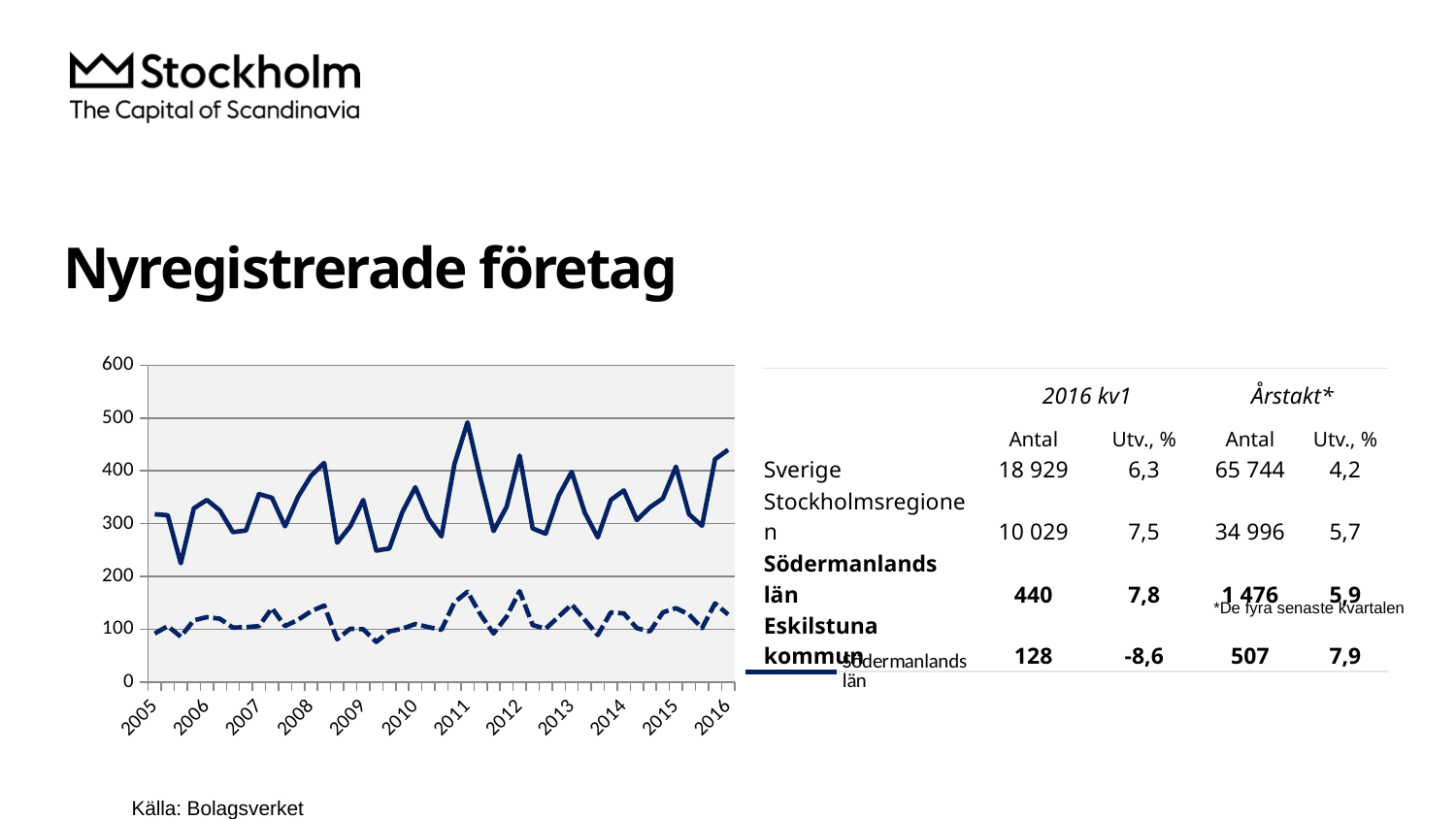
What is the title of the slide above the chart? Nyregistrerade företag How many year labels are shown on the x axis of the chart? 12 Which line is higher throughout the chart, the solid line or the dashed line? the solid line Around which year does the solid line (Södermanlands län) reach its highest value? 2011 Is the value of the solid line at the end of the series (2016) greater or less than 400? greater Is the lowest value of the solid line (Södermanlands län) greater or less than 300? less How many lines are plotted in the chart? 2 Is the peak value of the solid line (Södermanlands län) greater or less than 400? greater What is the highest value shown on the y axis of the chart? 600 What is the first year shown on the x axis of the chart? 2005 What kind of chart is shown on the slide? line chart